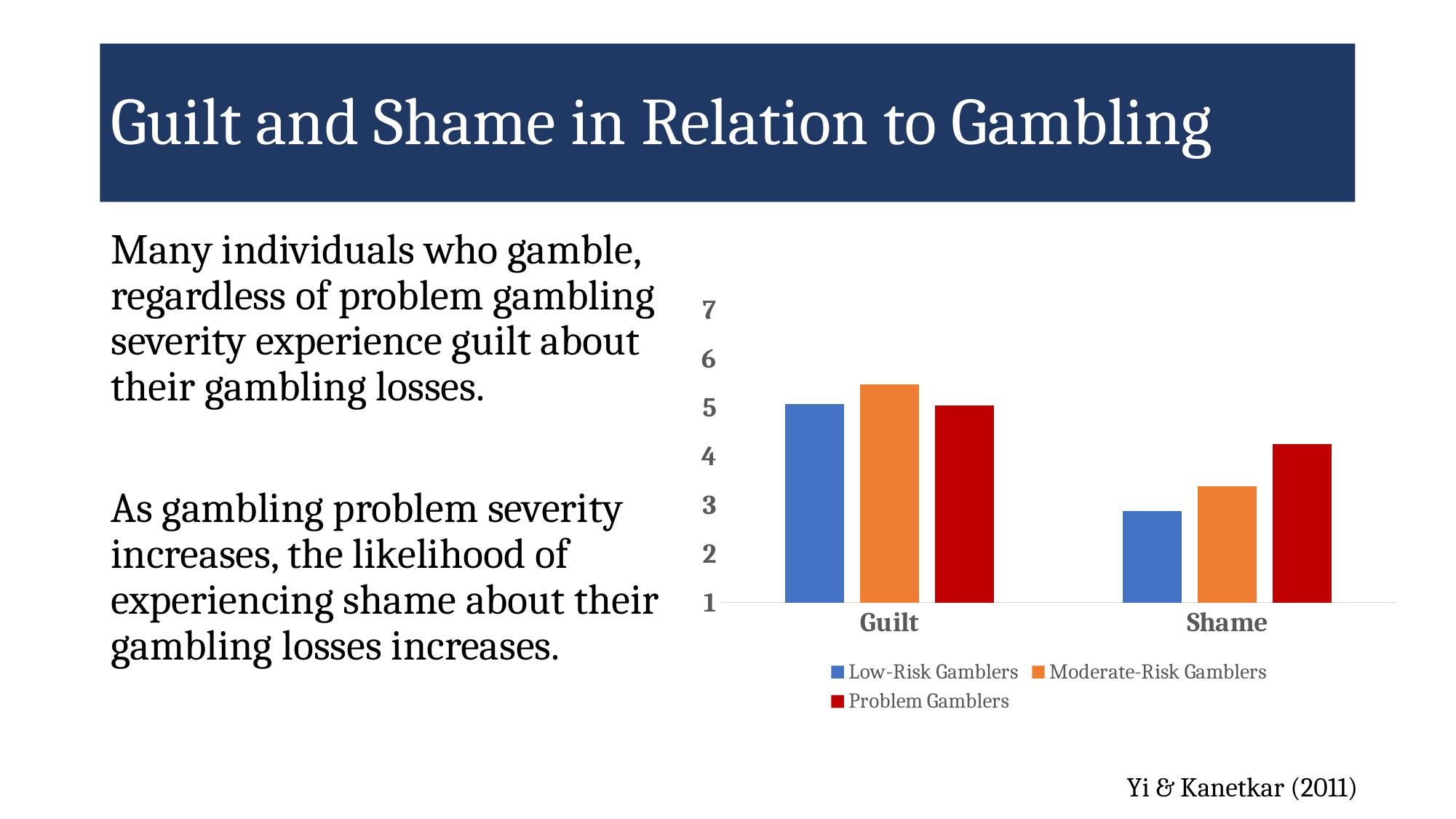
Which series has the highest value for Guilt? Moderate-Risk Gamblers Which series has the highest value for Shame? Problem Gamblers How many series does the chart's legend list? 3 For Problem Gamblers, which is larger: the value for Guilt or the value for Shame? Guilt Which series has the lowest value for Shame? Low-Risk Gamblers Is the value for Moderate-Risk Gamblers on Shame greater or less than 4? less Is the value for Moderate-Risk Gamblers on Guilt greater or less than 5? greater Do the values for Low-Risk Gamblers rise or fall from Guilt to Shame? fall What colour represents Problem Gamblers in the chart? red Is the value for Problem Gamblers on Shame greater or less than 4? greater How many categories are shown on the x axis of the chart? 2 What kind of chart is shown on the slide? bar chart